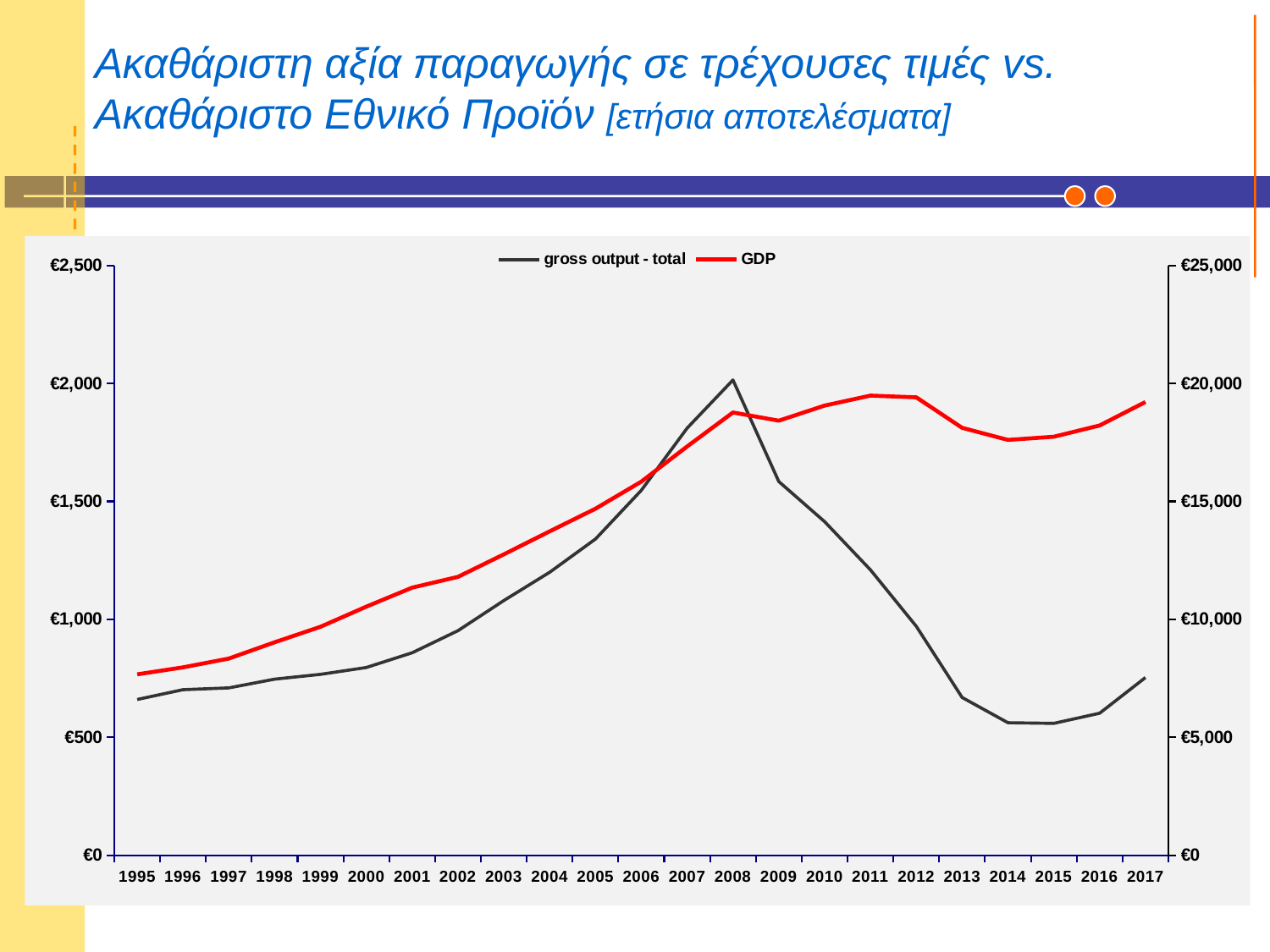
In which year does the gross output - total series reach its highest value? 2008 Is the value for gross output - total in 2013 greater or less than €1,000? less What colour is the GDP line in the chart? red Is the value for GDP in 1995 greater or less than €10,000? less Which is larger for gross output - total: the value in 2008 or the value in 2017? 2008 Is the value for gross output - total in 2014 greater or less than €1,000? less What kind of chart is shown on the slide? line chart In which year is the GDP series at its lowest value? 1995 Does the gross output - total series rise or fall between 2008 and 2014? fall How many series does the legend list? 2 How many years are plotted along the x axis? 23